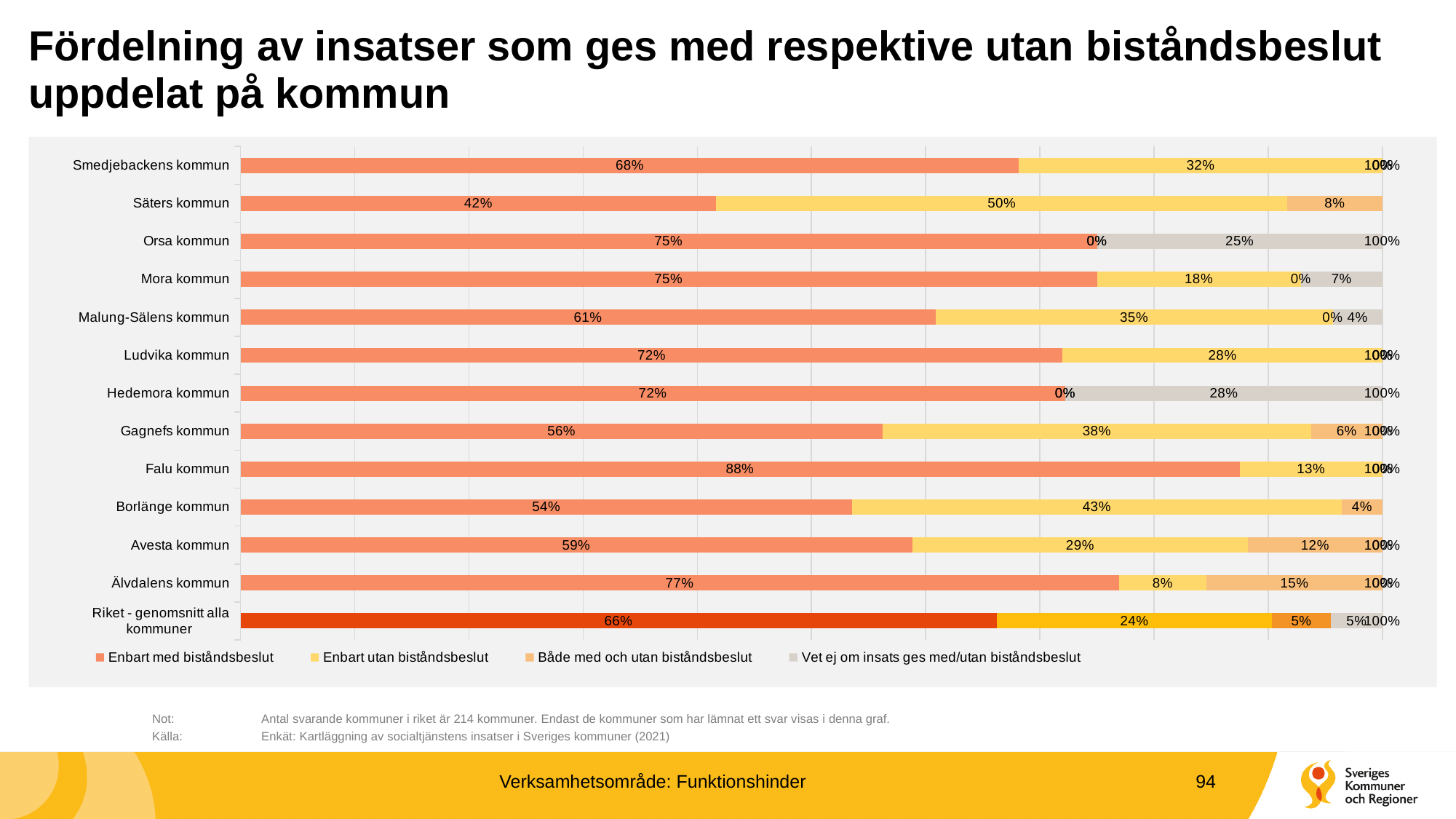
What is the difference between the 'Enbart med biståndsbeslut' values for Falu kommun and Säters kommun? 46 percentage points What is the value of 'Enbart utan biståndsbeslut' for Säters kommun? 50% Which category has the highest value for 'Enbart med biståndsbeslut'? Falu kommun What is the value of 'Enbart med biståndsbeslut' for Falu kommun? 88% What is the value of 'Både med och utan biståndsbeslut' for Älvdalens kommun? 15% What kind of chart is shown on the slide? Stacked bar chart How many series does the legend list? 4 What is the value of 'Vet ej om insats ges med/utan biståndsbeslut' for Hedemora kommun? 28% Which category has the lowest value for 'Enbart med biståndsbeslut'? Säters kommun Which has the larger 'Enbart utan biståndsbeslut' value, Borlänge kommun or Gagnefs kommun? Borlänge kommun What is the value of 'Enbart utan biståndsbeslut' for 'Riket - genomsnitt alla kommuner'? 24% How many categories (rows) are plotted in the chart? 13